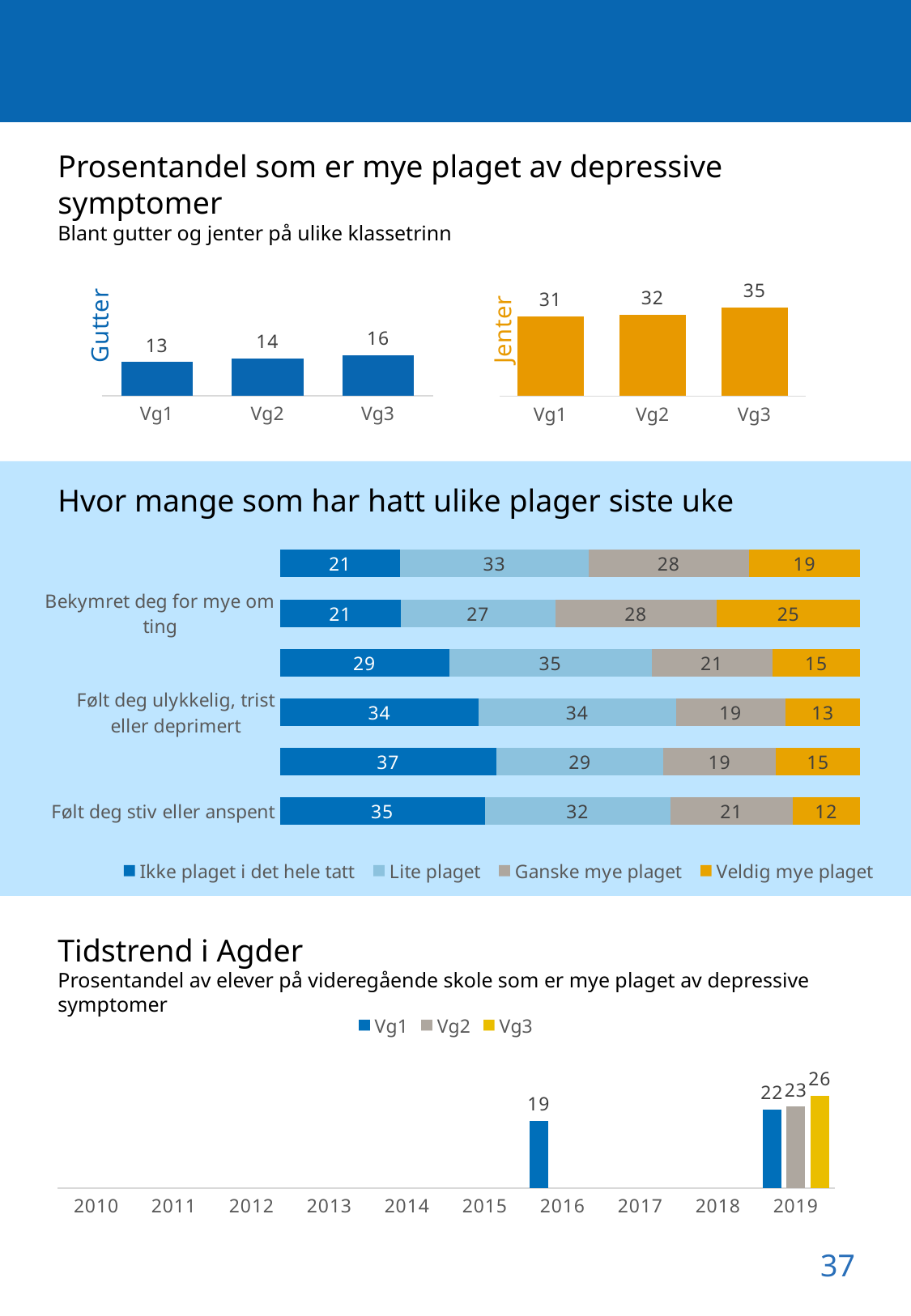
In the Jenter chart, what is the value for Vg1? 31 In the Gutter chart, what is the value for Vg3? 16 What is the difference between the Jenter value for Vg3 and the Gutter value for Vg3? 19 In the Jenter chart, which class level has the highest value? Vg3 In the 'Tidstrend i Agder' chart, what is the value for Vg3 in 2019? 26 In the chart 'Hvor mange som har hatt ulike plager siste uke', how many series does the legend list? 4 Which is larger: the Jenter value for Vg2 or the Gutter value for Vg2? Jenter Vg2 What kind of chart is the 'Tidstrend i Agder' chart? bar chart In the Gutter chart, which class level has the lowest value? Vg1 In the Gutter chart, do the values rise or fall from Vg1 to Vg3? rise In the chart 'Hvor mange som har hatt ulike plager siste uke', what is the 'Veldig mye plaget' value in the bar labelled 'Følt deg stiv eller anspent'? 12 In the chart 'Hvor mange som har hatt ulike plager siste uke', what is the total of the bar labelled 'Følt deg stiv eller anspent'? 100